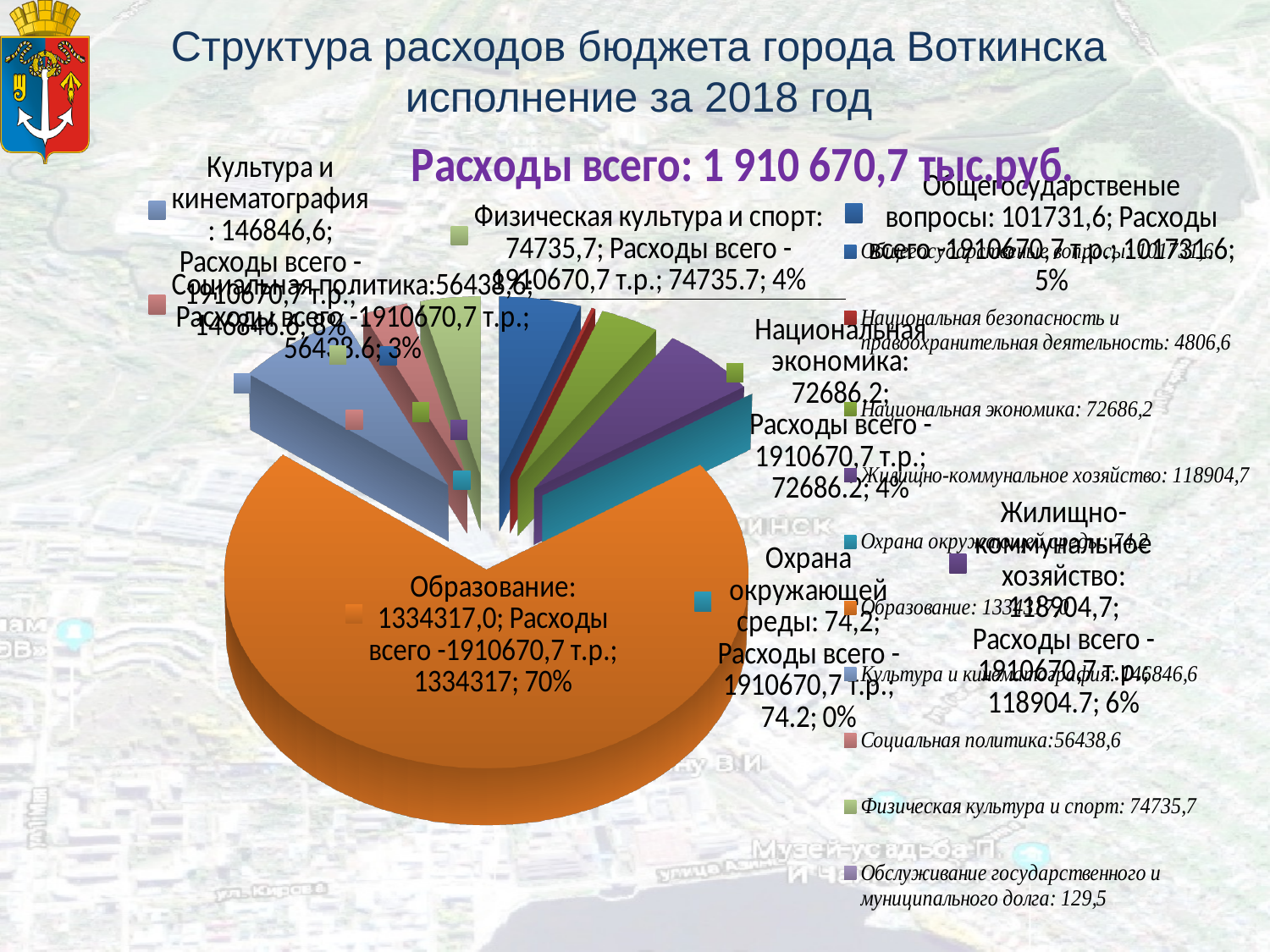
What value does the legend give for Образование? 1334317,0 Which category has the smallest value in the legend? Охрана окружающей среды What kind of chart is shown on the slide? pie chart What value does the legend give for Обслуживание государственного и муниципального долга? 129,5 Which is larger, Жилищно-коммунальное хозяйство or Общегосударственные вопросы? Жилищно-коммунальное хозяйство What share of the pie does Образование take according to its data label? 70% Which category has the largest slice of the pie? Образование What is the total expenditure stated in the chart heading? 1 910 670,7 тыс.руб. What value does the legend give for Национальная безопасность и правоохранительная деятельность? 4806,6 What value does the legend give for Жилищно-коммунальное хозяйство? 118904,7 How many categories does the legend list? 10 What share of the pie does Культура и кинематография take according to its data label? 8%